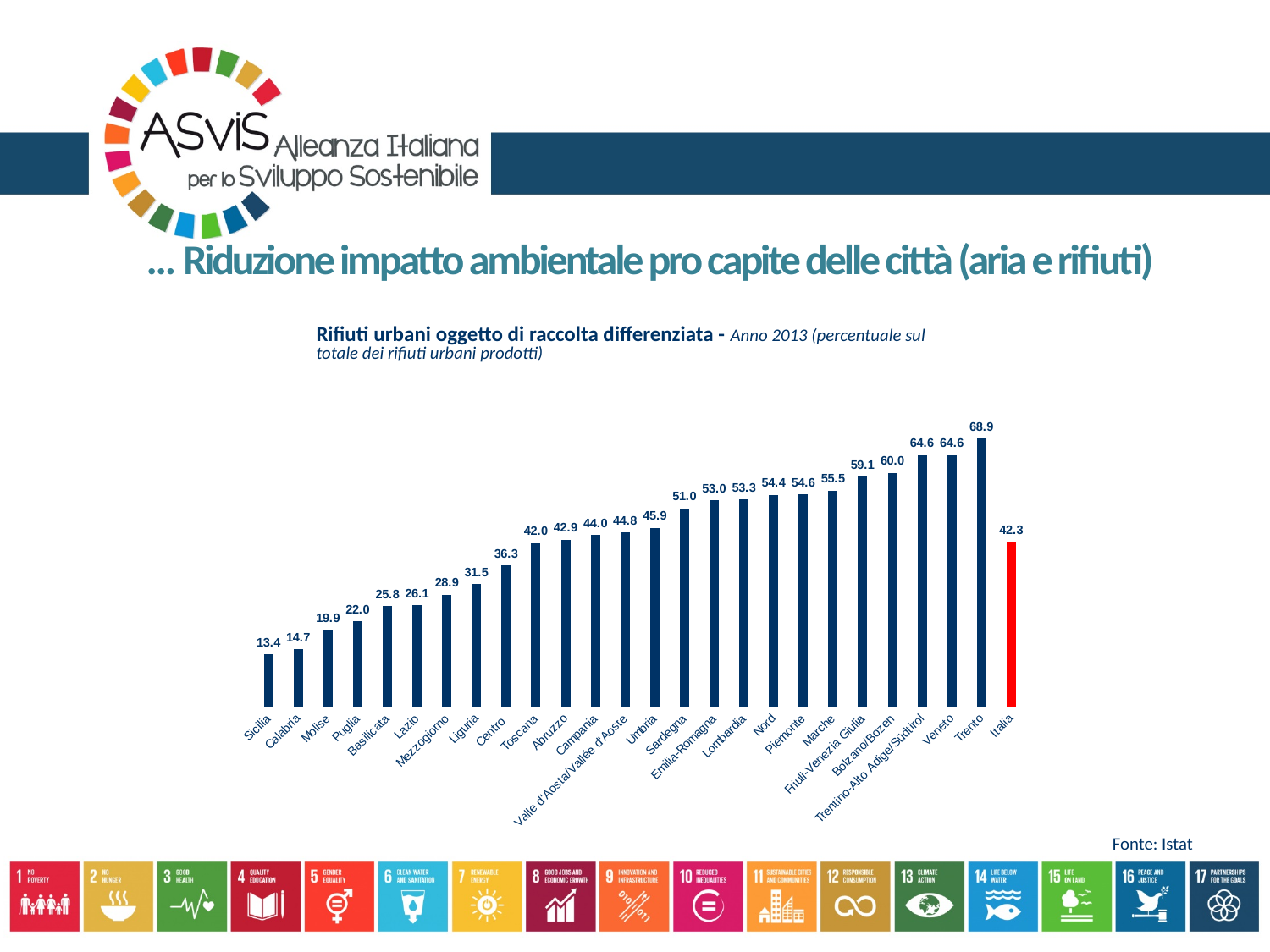
What is the difference between the values for Trento and Sicilia? 55.5 Which category has the highest value? Trento What is the value for Lombardia? 53.3 What is the difference between the values for Veneto and Italia? 22.3 What kind of chart is this? Bar chart How many categories are shown on the x axis? 26 What is the value for Italia? 42.3 Which is larger, the value for Nord or the value for Mezzogiorno? Nord Which bar is coloured red instead of blue? Italia What is the value for Sicilia? 13.4 What is the value for Trento? 68.9 Which category has the lowest value? Sicilia